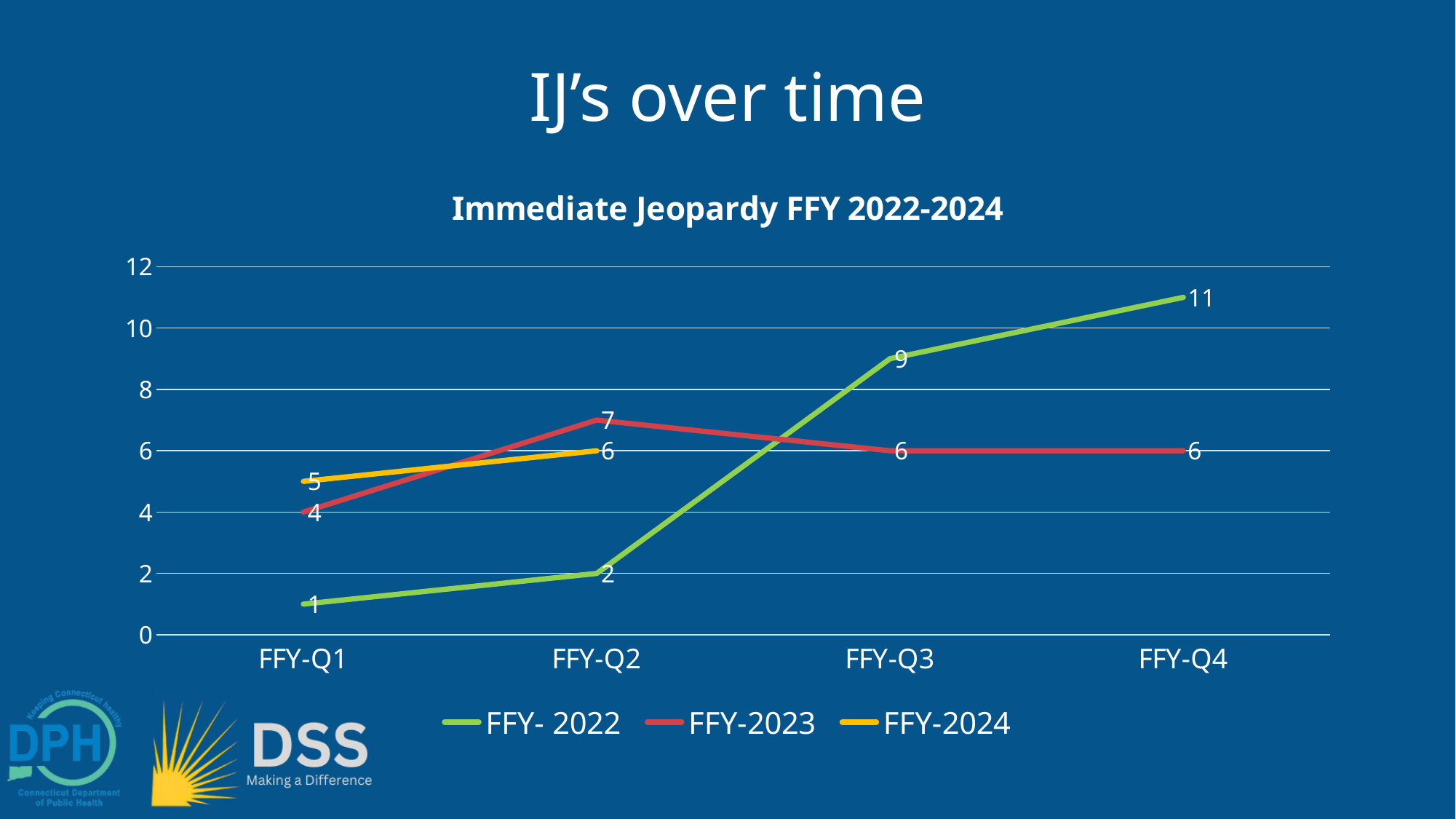
In which quarter does the FFY-2022 series reach its highest value? FFY-Q4 What is the difference between the FFY-2022 value at FFY-Q4 and the FFY-2023 value at FFY-Q4? 5 At FFY-Q2, which series has the larger value, FFY-2022 or FFY-2023? FFY-2023 What is the value for FFY-2022 at FFY-Q4? 11 What kind of chart is shown on the slide? Line chart What is the value for FFY-2022 at FFY-Q1? 1 What is the value for FFY-2023 at FFY-Q2? 7 In which quarter does the FFY-2023 series have its lowest value? FFY-Q1 Does the FFY-2022 series rise or fall from FFY-Q1 to FFY-Q4? Rise How many quarters are shown on the x axis? 4 What is the value for FFY-2024 at FFY-Q1? 5 How many series does the legend list? 3